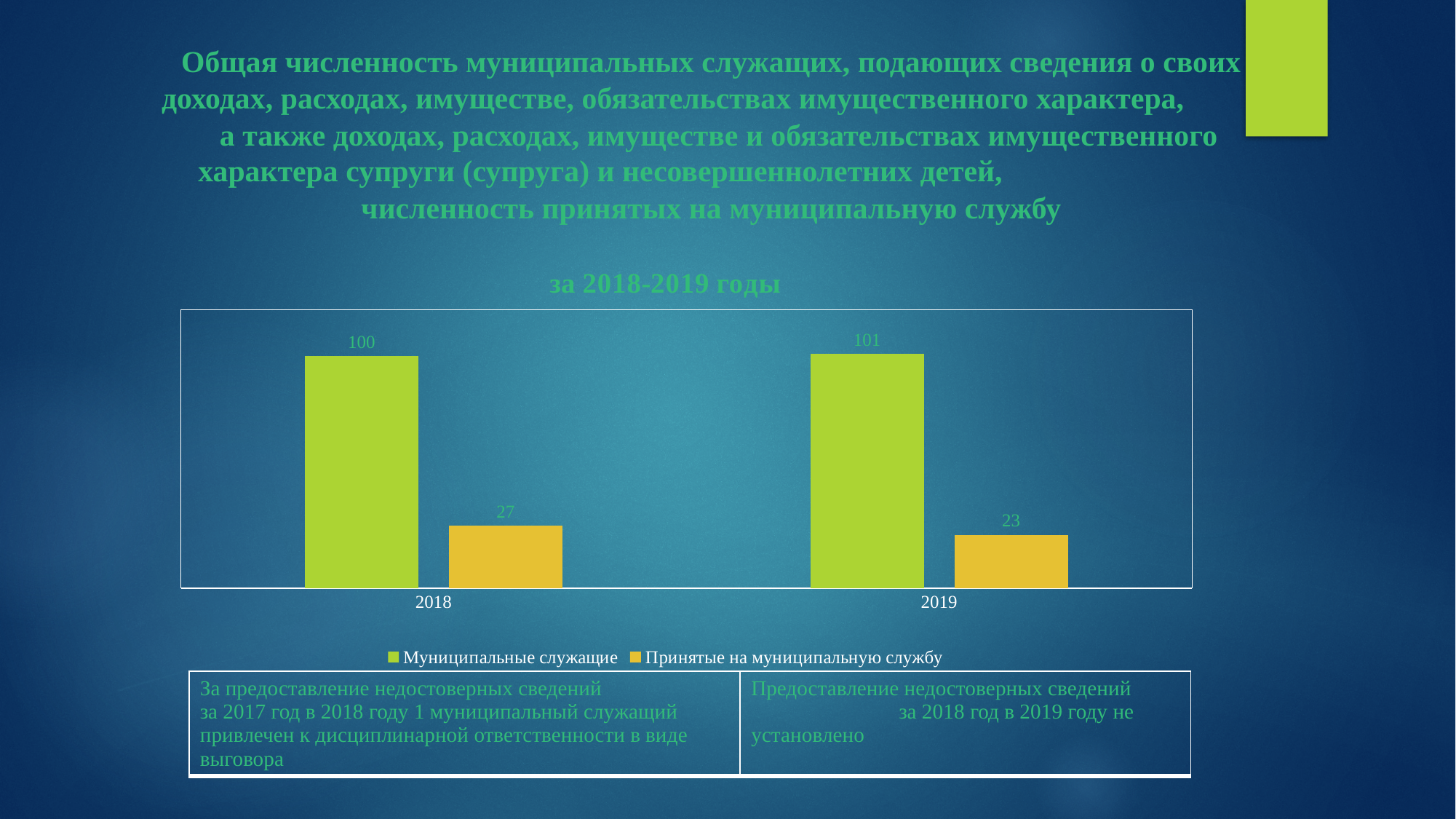
Which is larger in 2019: Муниципальные служащие or Принятые на муниципальную службу? Муниципальные служащие What is the difference between Муниципальные служащие and Принятые на муниципальную службу in 2018? 73 How many series does the legend list? 2 What kind of chart is shown on the slide? Bar chart What is the value for Принятые на муниципальную службу in 2019? 23 What is the value for Муниципальные служащие in 2018? 100 What is the value for Принятые на муниципальную службу in 2018? 27 Which year has the higher value for Принятые на муниципальную службу? 2018 What is the value for Муниципальные служащие in 2019? 101 By how much did Принятые на муниципальную службу change from 2018 to 2019? 4 How many years (categories) are shown on the x axis? 2 Does the value for Принятые на муниципальную службу rise or fall from 2018 to 2019? Fall